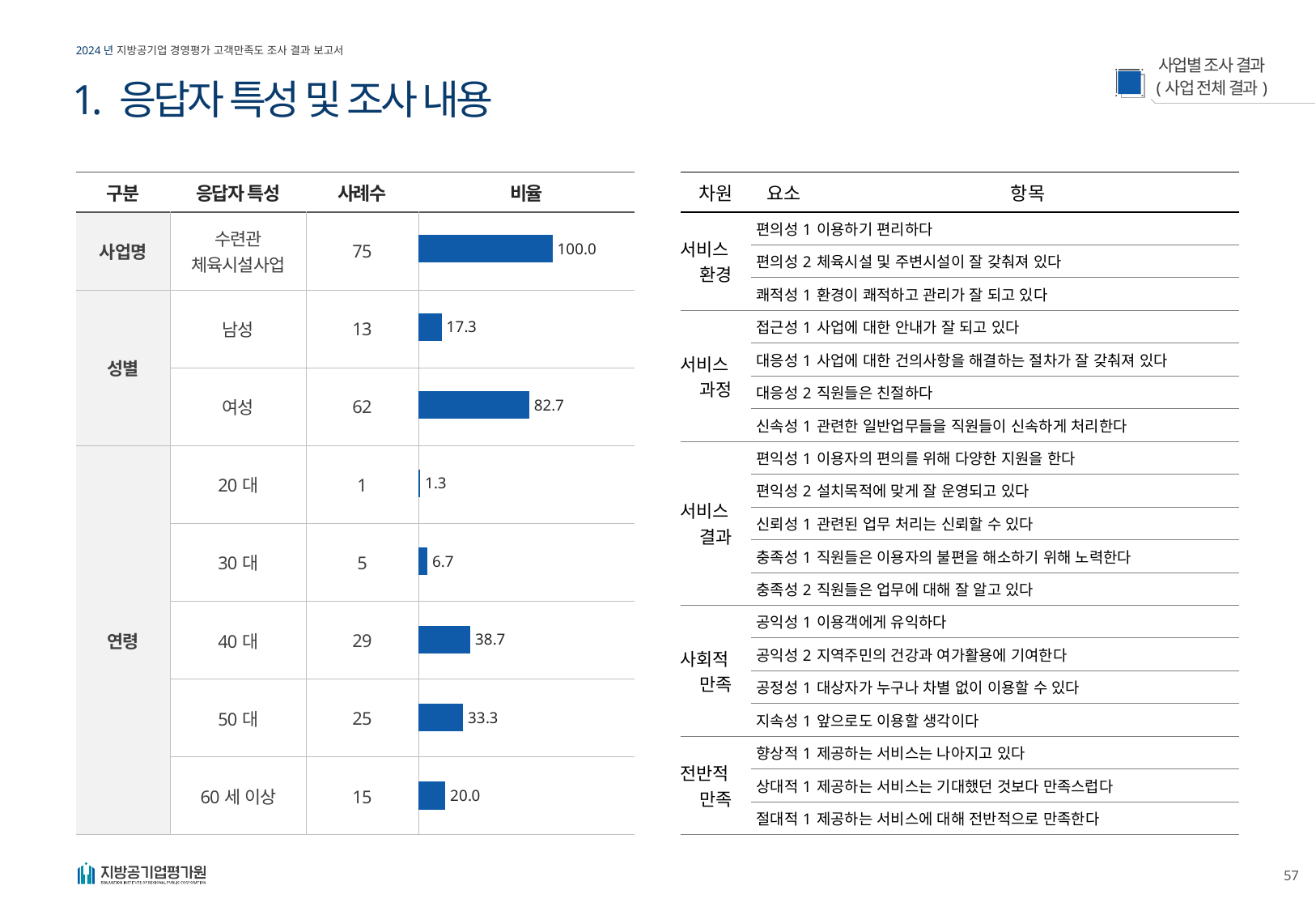
How many 연령 (age) categories have bars in the chart? 5 What is the 비율 value shown for 40 대 in the bar chart? 38.7 What is the difference between the 비율 values for 여성 and 남성? 65.4 What is the difference between the 비율 values for 40 대 and 50 대? 5.4 What type of chart is used in the 비율 column? Bar chart What is the 비율 value shown for 여성 in the bar chart? 82.7 What is the 비율 value shown for 남성 in the bar chart? 17.3 Which has a larger 비율 value, 50 대 or 60 세 이상? 50 대 Among the 연령 (age) groups, which has the highest 비율 bar? 40 대 What is the 사례수 (number of cases) for 30 대? 5 What is the 비율 value shown for 60 세 이상 in the bar chart? 20.0 Among the 연령 (age) groups, which has the lowest 비율 bar? 20 대